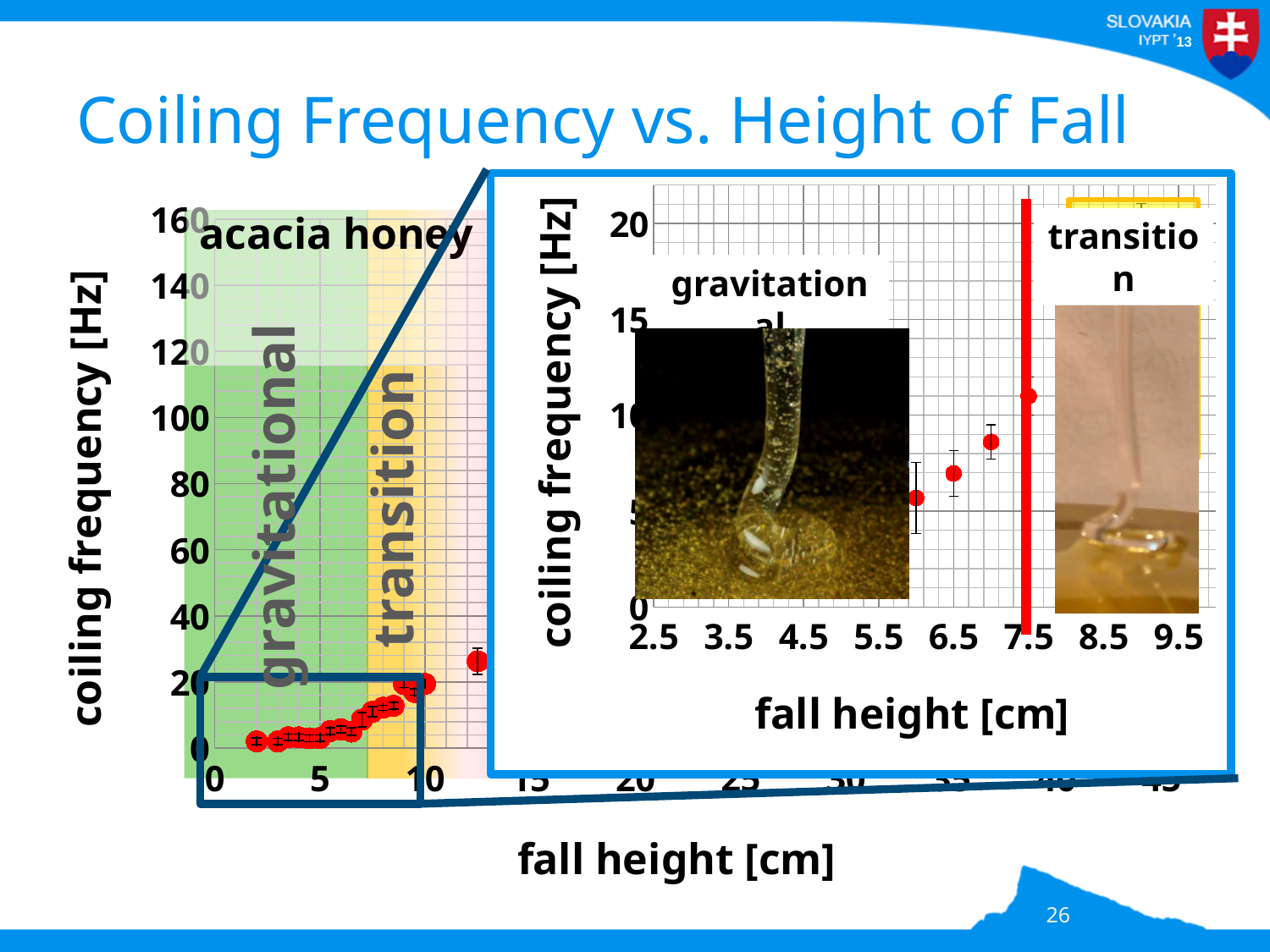
What is the title printed inside the main chart? acacia honey What is the y-axis label of the main chart? coiling frequency [Hz] In the inset chart, what is the highest labelled value on the y axis? 20 In the inset chart, does the coiling frequency rise or fall as fall height increases from 6 cm to 7.5 cm? rise In the inset chart, is the coiling frequency at a fall height of 7 cm greater or less than 10 Hz? less In the main chart, what is the highest value shown on the y axis? 160 In the main chart, is the coiling frequency at a fall height of about 12 cm greater or less than 20 Hz? greater In the main chart, what is the x-axis tick spacing between labelled values? 5 In the main chart, does the coiling frequency rise or fall as fall height increases? rise In the inset chart, is the coiling frequency at a fall height of 6 cm greater or less than 5 Hz? greater What kind of chart is the main chart on the slide? scatter chart In the inset chart, what is the lowest labelled value on the x axis? 2.5